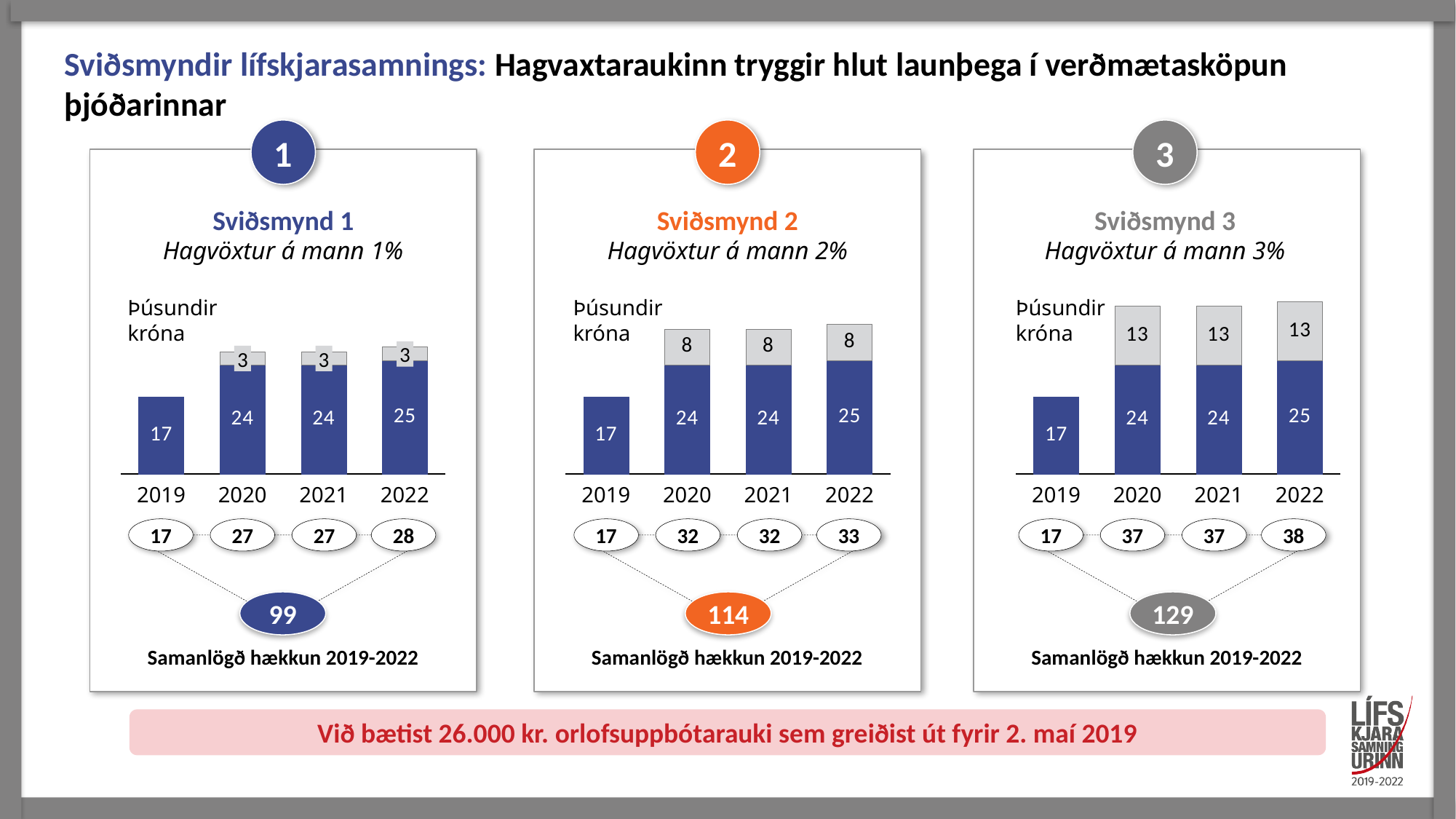
In the Sviðsmynd 3 chart, what is the value of the grey segment for 2020? 13 In the Sviðsmynd 2 chart, what is the total of the stacked bar for 2020? 32 In the Sviðsmynd 3 chart, which year has the highest total bar? 2022 How many years are shown on the x axis of the Sviðsmynd 1 chart? 4 In the Sviðsmynd 1 chart, what is the value of the dark blue segment for 2022? 25 Is the grey segment for 2022 larger in the Sviðsmynd 3 chart or in the Sviðsmynd 1 chart? Sviðsmynd 3 In the Sviðsmynd 2 chart, what is the value of the grey segment for 2021? 8 What is the unit label shown above the bars in each chart? Þúsundir króna In the Sviðsmynd 1 chart, which year has the lowest total bar? 2019 What kind of chart is used in the Sviðsmynd 2 panel? Stacked bar chart In the Sviðsmynd 2 chart, what is the difference between the dark blue segment for 2020 and the dark blue segment for 2019? 7 In the Sviðsmynd 3 chart, what is the total of the stacked bar for 2022? 38